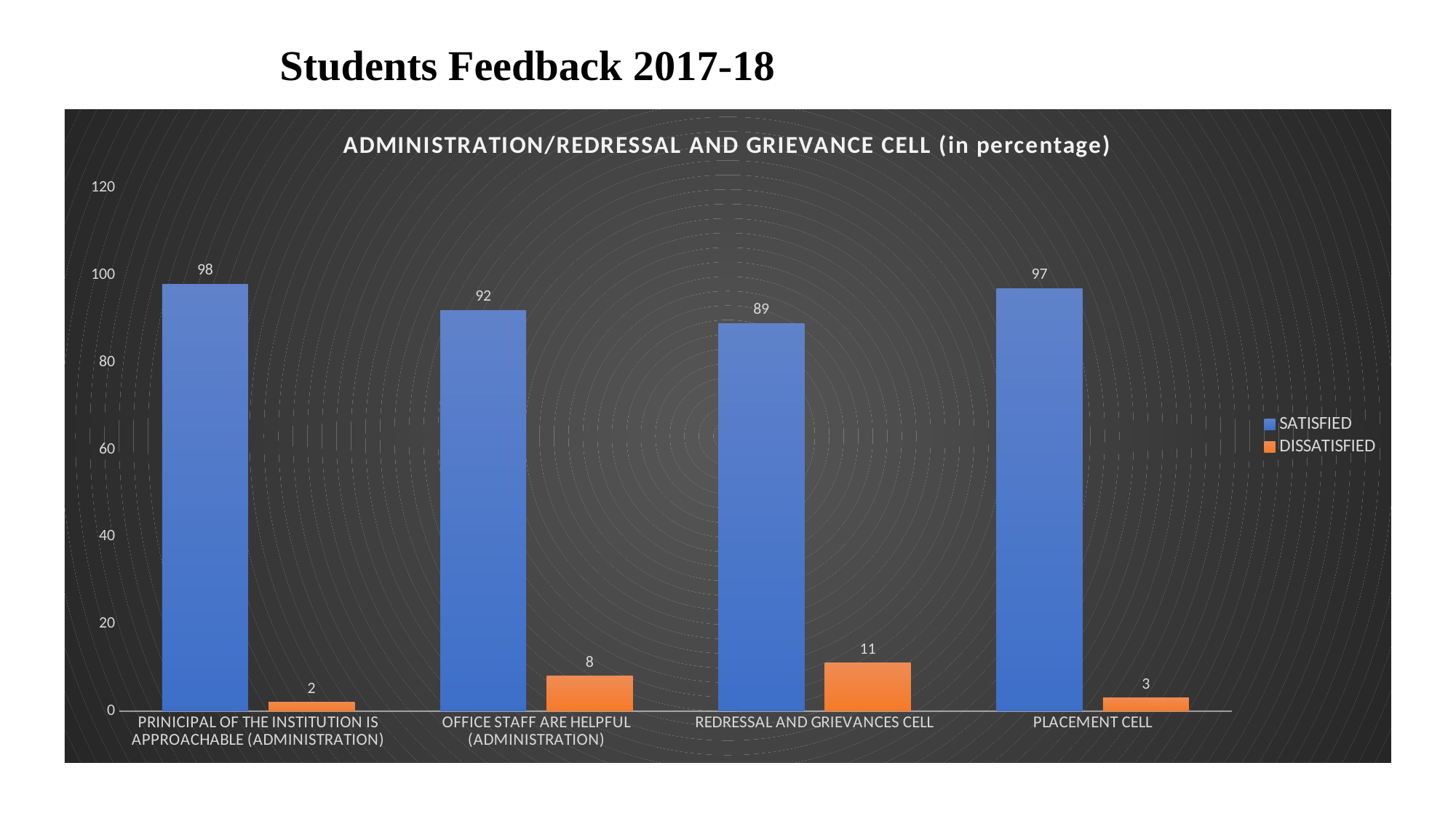
How many series does the legend list? 2 What is the SATISFIED value for PLACEMENT CELL? 97 What is the DISSATISFIED value for REDRESSAL AND GRIEVANCES CELL? 11 What is the SATISFIED value for OFFICE STAFF ARE HELPFUL (ADMINISTRATION)? 92 What is the title of the chart? ADMINISTRATION/REDRESSAL AND GRIEVANCE CELL (in percentage) What is the difference between the SATISFIED and DISSATISFIED values for REDRESSAL AND GRIEVANCES CELL? 78 Is the SATISFIED value for REDRESSAL AND GRIEVANCES CELL greater or less than 100? less Which category has the highest SATISFIED value? PRINICIPAL OF THE INSTITUTION IS APPROACHABLE (ADMINISTRATION) Which is larger: the DISSATISFIED value for OFFICE STAFF ARE HELPFUL (ADMINISTRATION) or for PLACEMENT CELL? OFFICE STAFF ARE HELPFUL (ADMINISTRATION) What kind of chart is shown on the slide? bar chart Which category has the lowest DISSATISFIED value? PRINICIPAL OF THE INSTITUTION IS APPROACHABLE (ADMINISTRATION) How many categories are shown on the x axis? 4